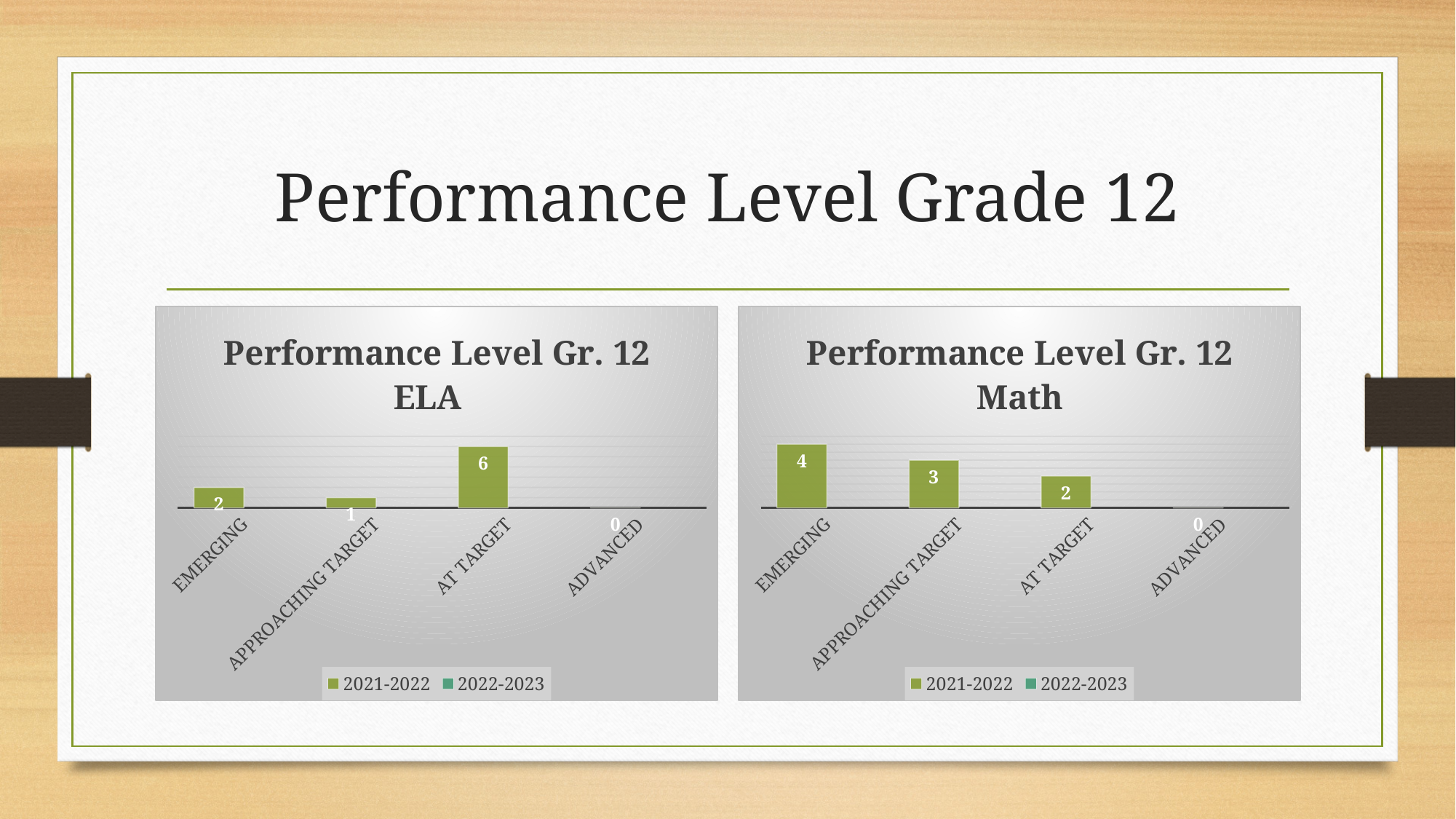
In the Performance Level Gr. 12 Math chart, what is the 2021-2022 value for EMERGING? 4 In the Performance Level Gr. 12 Math chart, what is the difference between the 2021-2022 values for EMERGING and AT TARGET? 2 How many series does the legend of the Performance Level Gr. 12 ELA chart list? 2 In the Performance Level Gr. 12 ELA chart, what is the 2021-2022 value for AT TARGET? 6 In the Performance Level Gr. 12 ELA chart, what is the 2021-2022 value for APPROACHING TARGET? 1 In the Performance Level Gr. 12 Math chart, which category has the lowest 2021-2022 value? ADVANCED In the Performance Level Gr. 12 ELA chart, which category has the highest 2021-2022 value? AT TARGET What kind of chart is the Performance Level Gr. 12 Math chart? Bar chart In the Performance Level Gr. 12 ELA chart, which is larger for 2021-2022: EMERGING or APPROACHING TARGET? EMERGING How many categories are shown on the x axis of the Performance Level Gr. 12 Math chart? 4 In the Performance Level Gr. 12 Math chart, do the 2021-2022 values rise or fall from EMERGING to ADVANCED? Fall In the Performance Level Gr. 12 Math chart, what is the 2021-2022 value for ADVANCED? 0